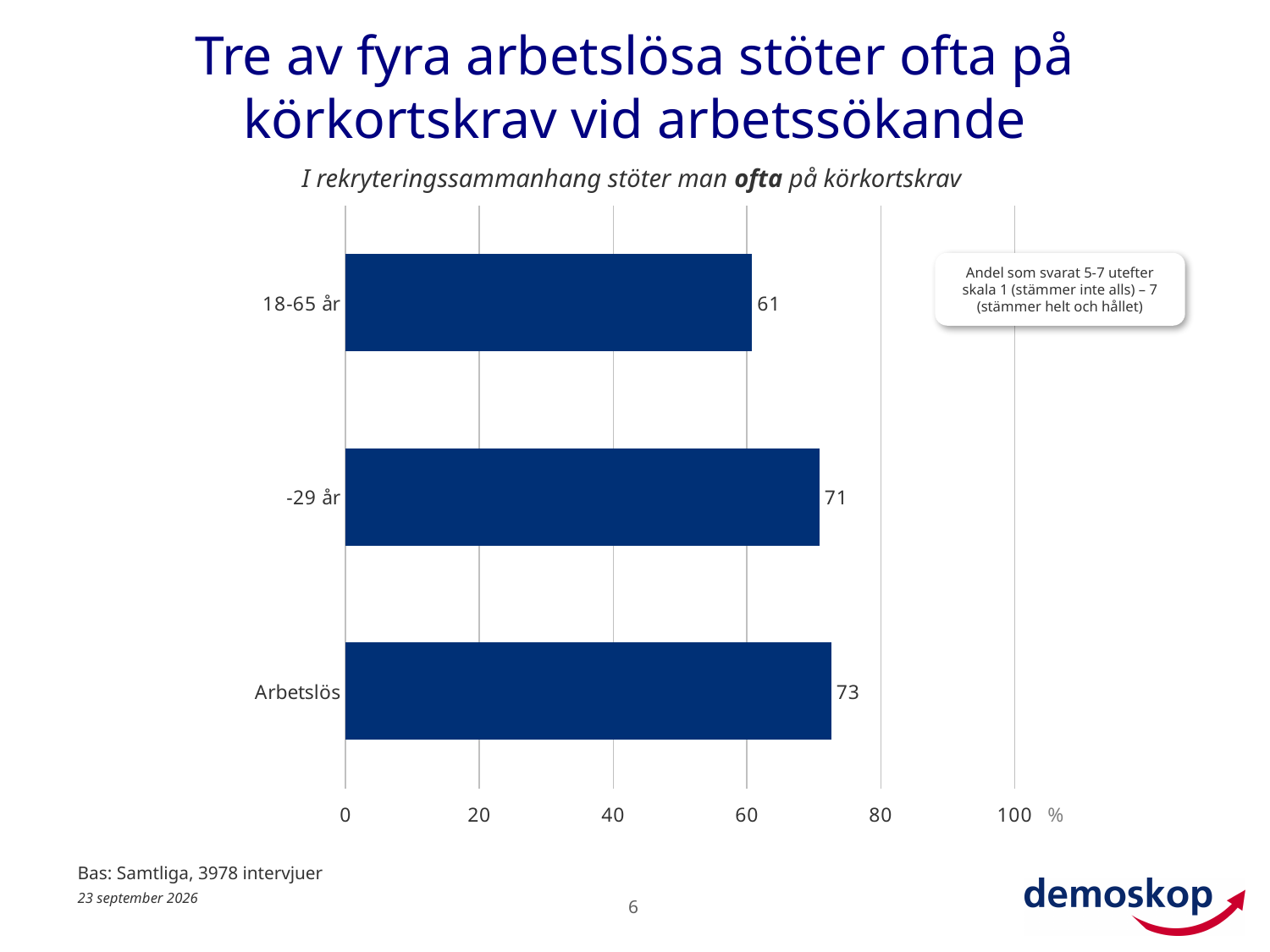
What is the value for 18-65 år? 61 What is the difference between the values for Arbetslös and 18-65 år? 12 What kind of chart is shown on the slide? bar chart What is the subtitle shown above the chart? I rekryteringssammanhang stöter man ofta på körkortskrav What is the difference between the values for -29 år and 18-65 år? 10 How many categories are shown in the chart? 3 What is the value for -29 år? 71 Is the value for 18-65 år greater or less than 80? less What is the value for Arbetslös? 73 Which is larger, the value for -29 år or the value for 18-65 år? -29 år Which category has the lowest value? 18-65 år Which category has the highest value? Arbetslös